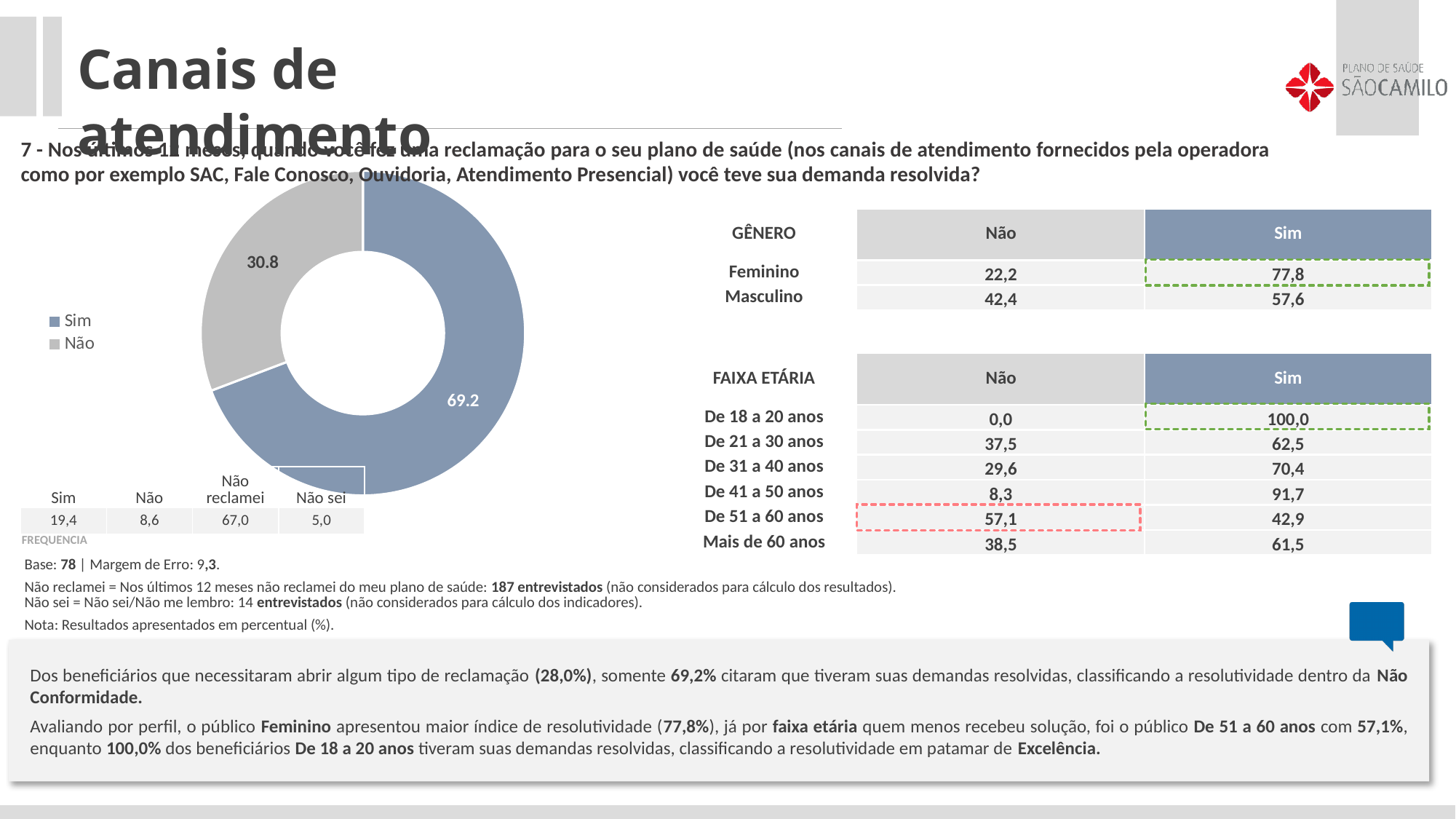
Which slice of the donut chart is the smallest? Não In the donut chart, is the value for Sim greater or less than 50? greater In the donut chart, what is the difference between the Sim value and the Não value? 38.4 What colour is the Sim slice in the donut chart? Blue In the donut chart, what is the value shown for Não? 30.8 Which slice of the donut chart is the largest? Sim How many slices does the donut chart have? 2 In the donut chart, which is larger: Sim or Não? Sim In the donut chart, what is the value shown for Sim? 69.2 What kind of chart is shown on the left of the slide? Pie (donut) chart How many entries does the legend of the donut chart list? 2 What share of the donut chart does the Não slice represent? 30.8